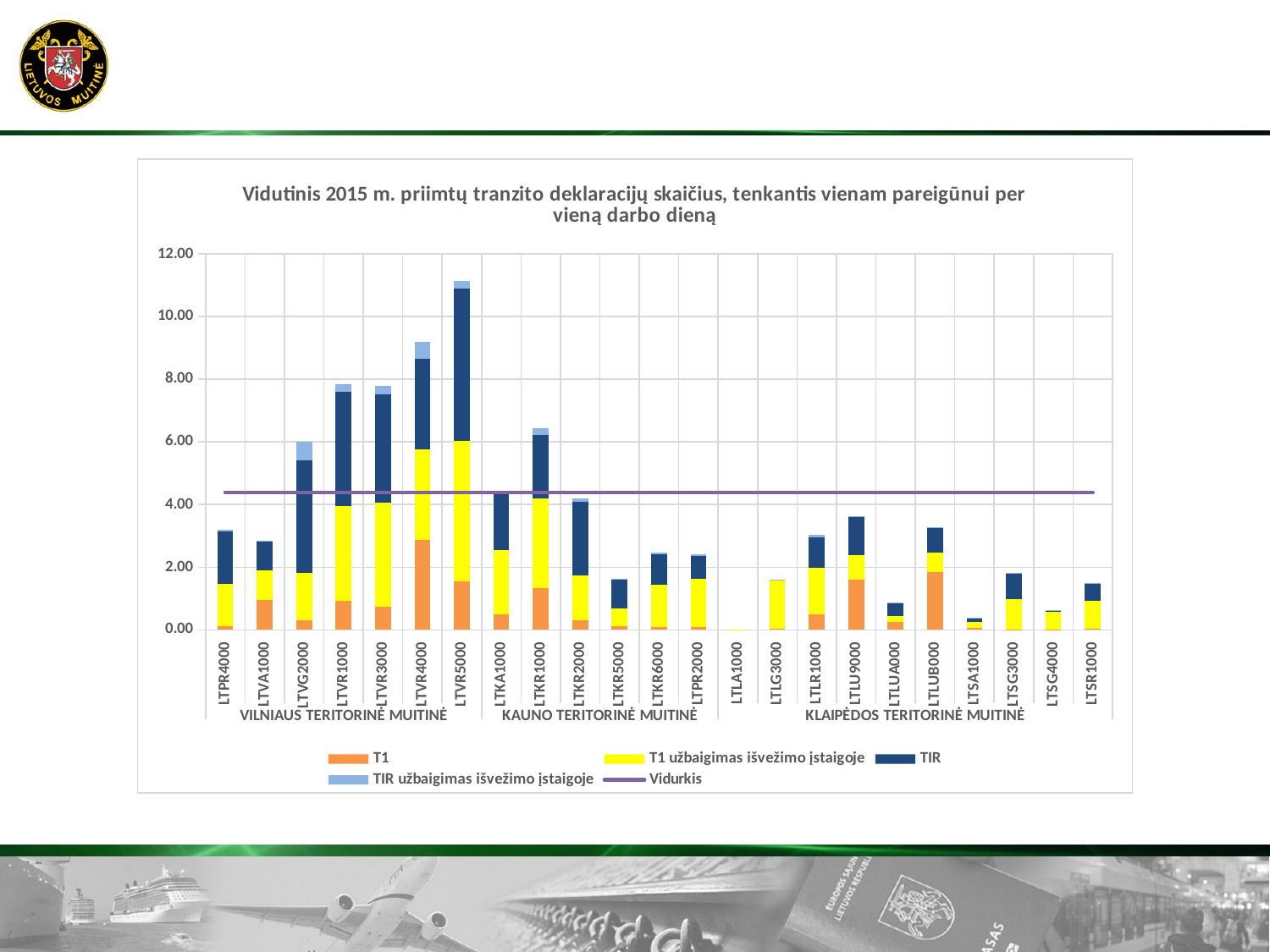
Which has the taller stacked bar, LTLU9000 or LTSA1000? LTLU9000 Is the total stacked value for LTVR5000 greater or less than 10.00? greater How many series does the legend list? 5 How many customs post categories are plotted along the x axis? 23 Which legend entry is represented by the purple horizontal line? Vidurkis Into which three territorial customs groups are the categories on the x axis divided? Vilniaus teritorinė muitinė, Kauno teritorinė muitinė, Klaipėdos teritorinė muitinė Which category has the tallest stacked bar? LTVR5000 Is the total stacked value for LTKR5000 greater or less than 2.00? less Which has the taller stacked bar, LTVR1000 or LTKA1000? LTVR1000 What kind of chart is shown on the slide? Stacked bar chart with a line Which category has the smallest stacked bar? LTLA1000 Is the total stacked value for LTVR4000 greater or less than 8.00? greater